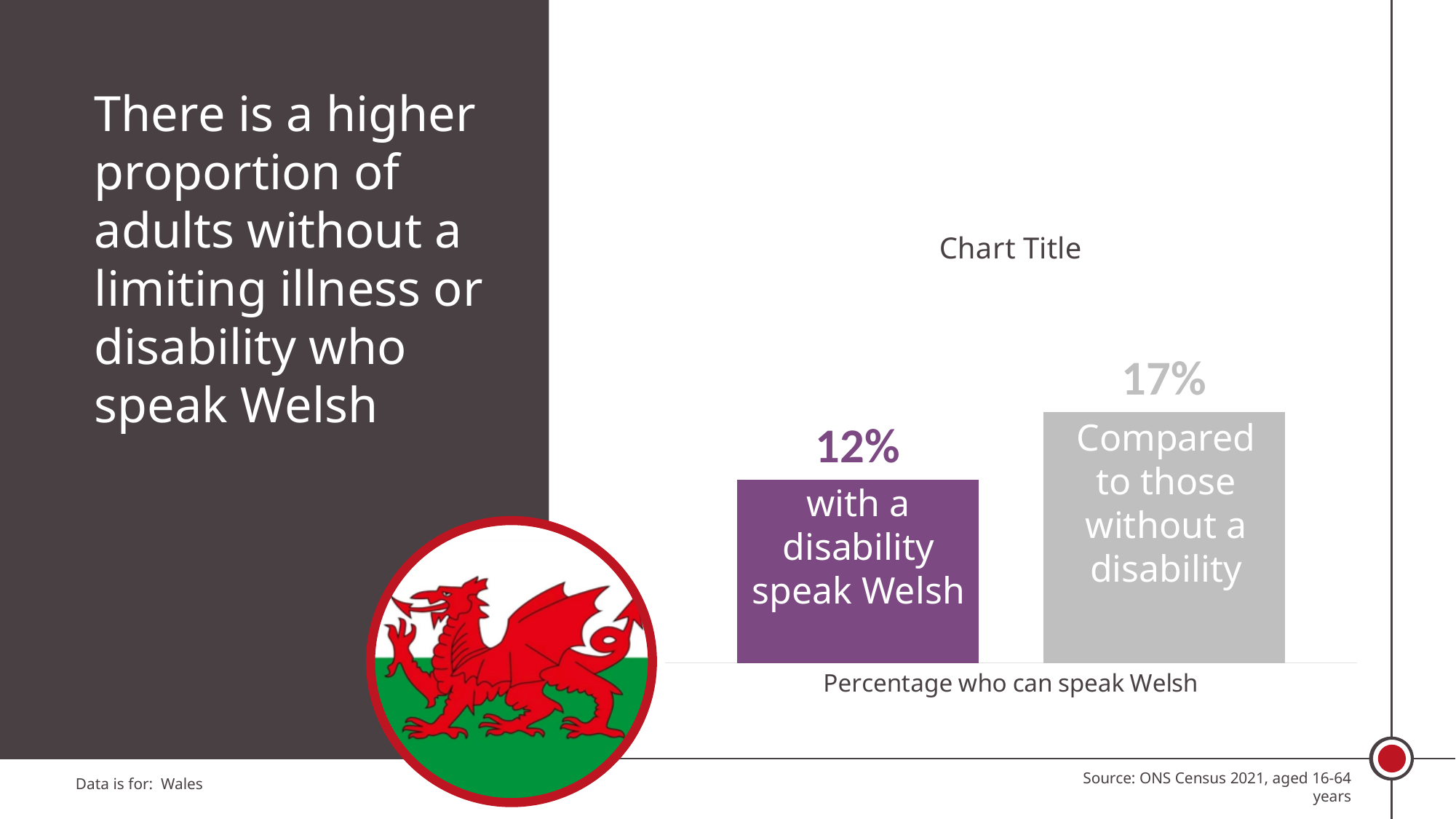
How many bars are shown in the chart? 2 What is the label shown beneath the bars on the x axis? Percentage who can speak Welsh What percentage of adults without a disability can speak Welsh? 17% Which group has the higher percentage who can speak Welsh? Those without a disability Is the percentage who can speak Welsh larger for adults with a disability or adults without a disability? Adults without a disability What is the difference in percentage points between adults without a disability and adults with a disability who can speak Welsh? 5 percentage points What type of chart is shown on the slide? Bar chart What percentage of adults with a disability can speak Welsh? 12% Which group has the lower percentage who can speak Welsh? Those with a disability What is the title shown above the chart? Chart Title